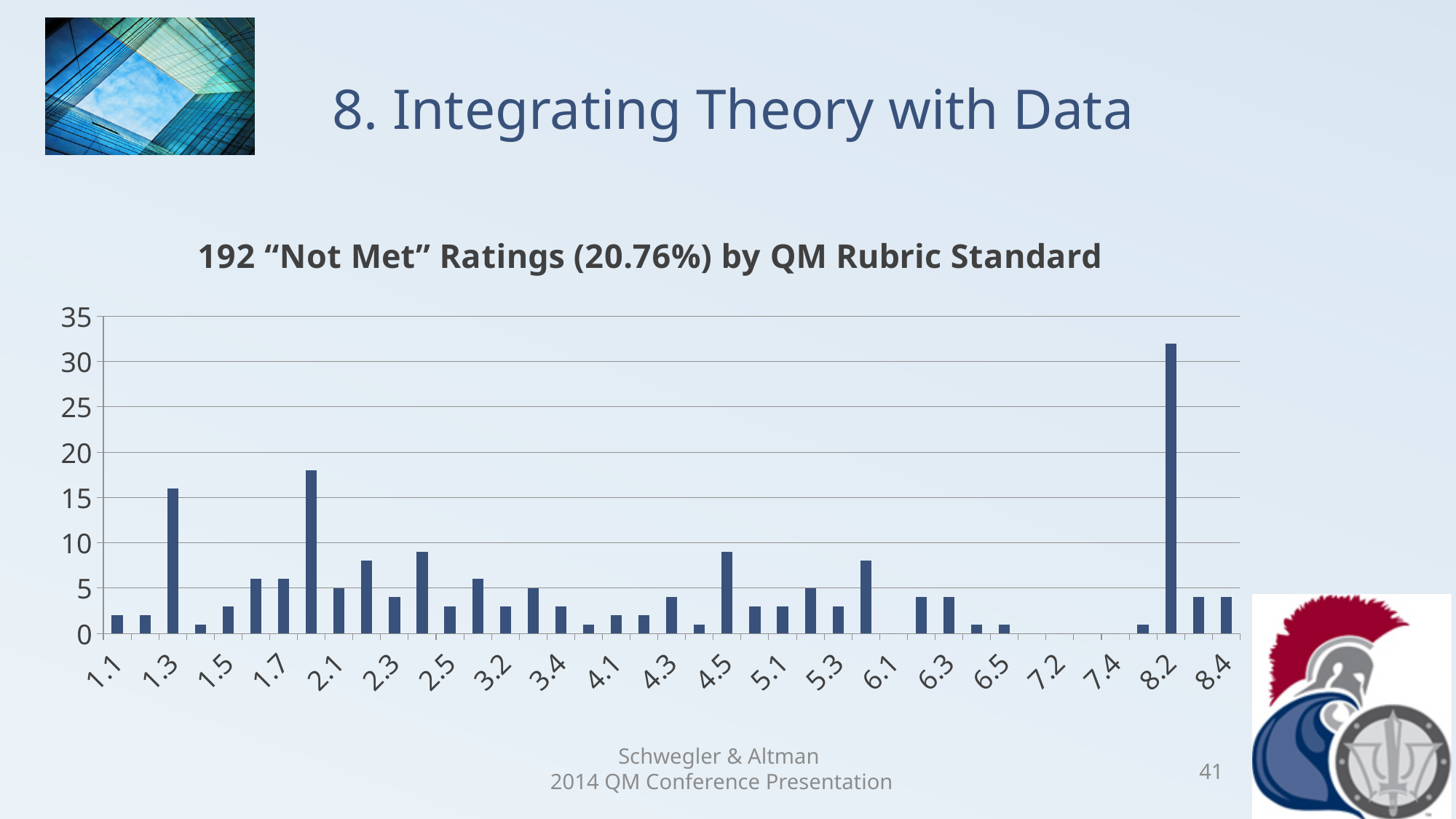
Is the value for standard 1.1 greater or less than 5? less Which has more "Not Met" ratings, standard 1.3 or standard 8.2? 8.2 Which QM rubric standard has the highest number of "Not Met" ratings? 8.2 Is the value for standard 7.2 greater or less than 5? less Is the value for standard 4.5 greater or less than 5? greater What is the maximum value shown on the vertical axis? 35 What type of chart is shown on the slide? bar chart Which has more "Not Met" ratings, standard 1.3 or standard 4.5? 1.3 What is the title of the chart? 192 "Not Met" Ratings (20.76%) by QM Rubric Standard